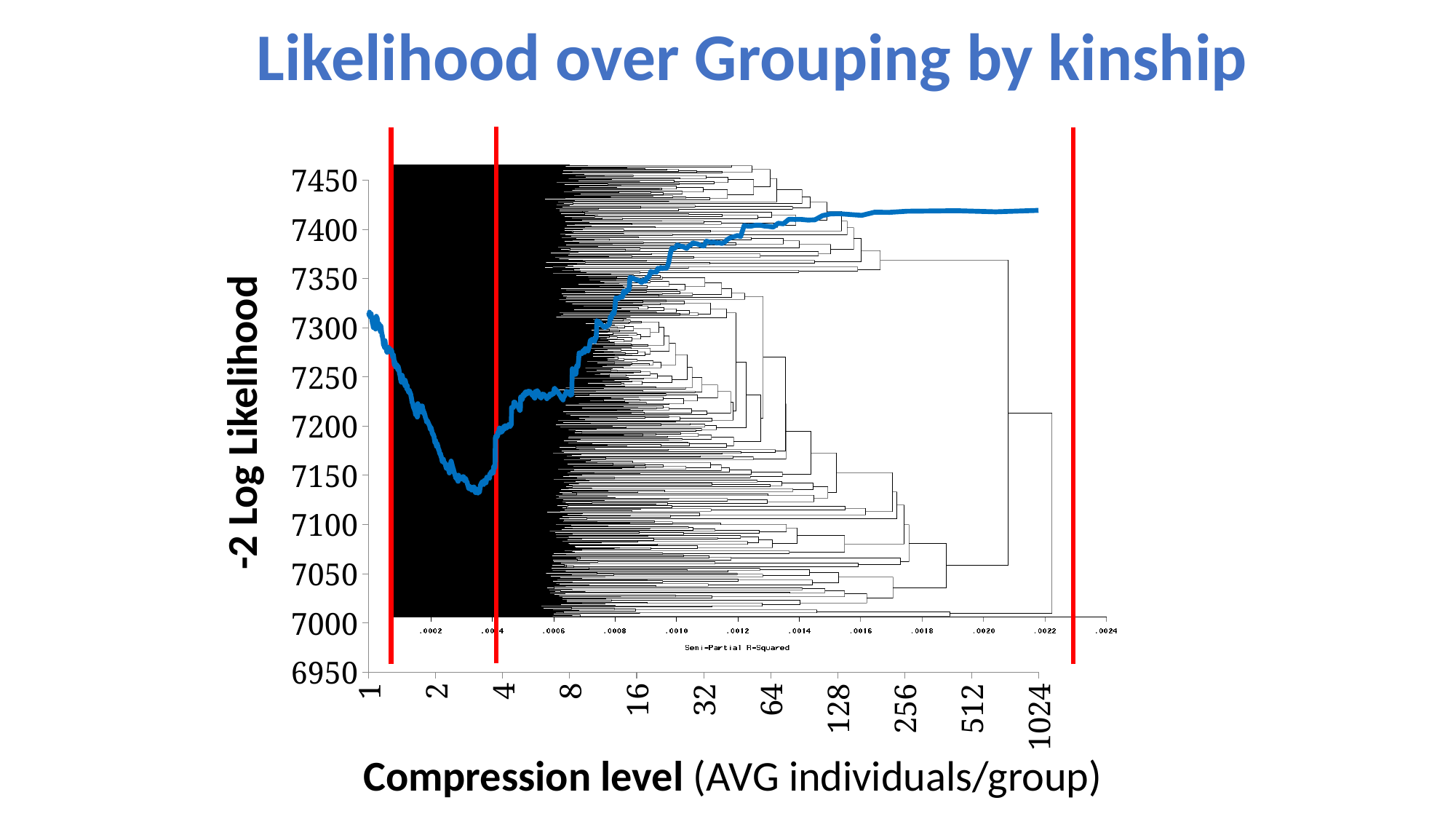
What is the title of the chart? Likelihood over Grouping by kinship How many tick labels are shown on the x axis (Compression level)? 11 Is the value of the blue line at compression level 32 greater or less than 7350? greater Between which two x-axis tick labels does the blue line reach its lowest value? 2 and 4 Which is larger, the value of the blue line at compression level 4 or at compression level 16? 16 What kind of chart is shown on the slide? line chart Is the lowest point of the blue line greater or less than 7150? less Is the value of the blue line at compression level 8 greater or less than 7200? greater What is the label of the y axis? -2 Log Likelihood Which is larger, the value of the blue line at compression level 1 or at compression level 1024? 1024 Does the blue line rise or fall as the compression level increases from 8 to 1024? rise